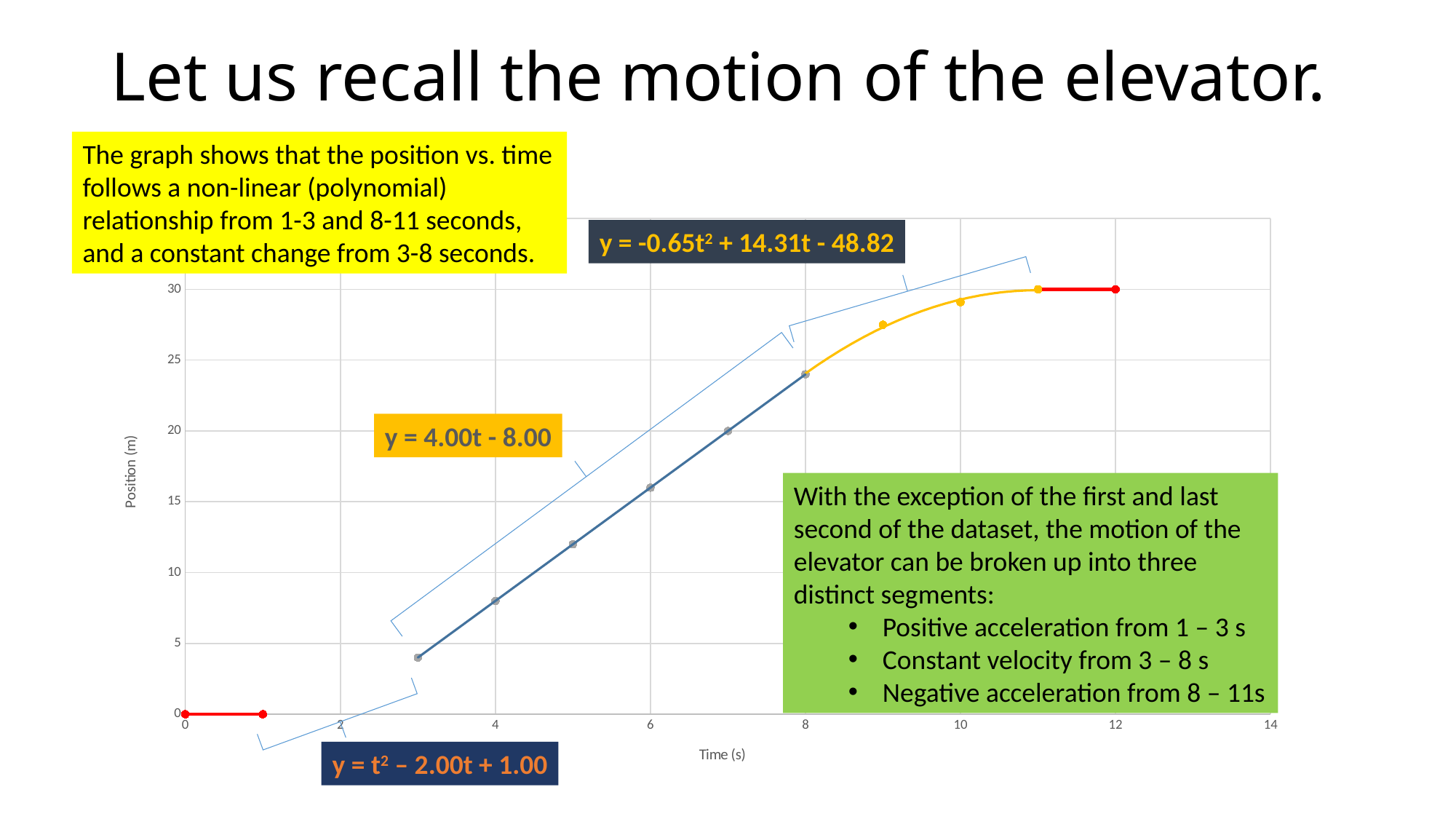
Which is larger, the position at 6 s or the position at 10 s? 10 s Does the position rise or fall as time increases from 3 s to 8 s? rise Is the position at time 5 s greater or less than 10? greater What is the position at time 7 s? 20 What kind of chart is shown on the slide? line chart Is the position at time 3 s greater or less than 5? less What is the label of the y axis? Position (m) What is the position at time 11 s? 30 What is the label of the x axis? Time (s) What is the position at time 0 s? 0 Is the position at time 8 s greater or less than 25? less